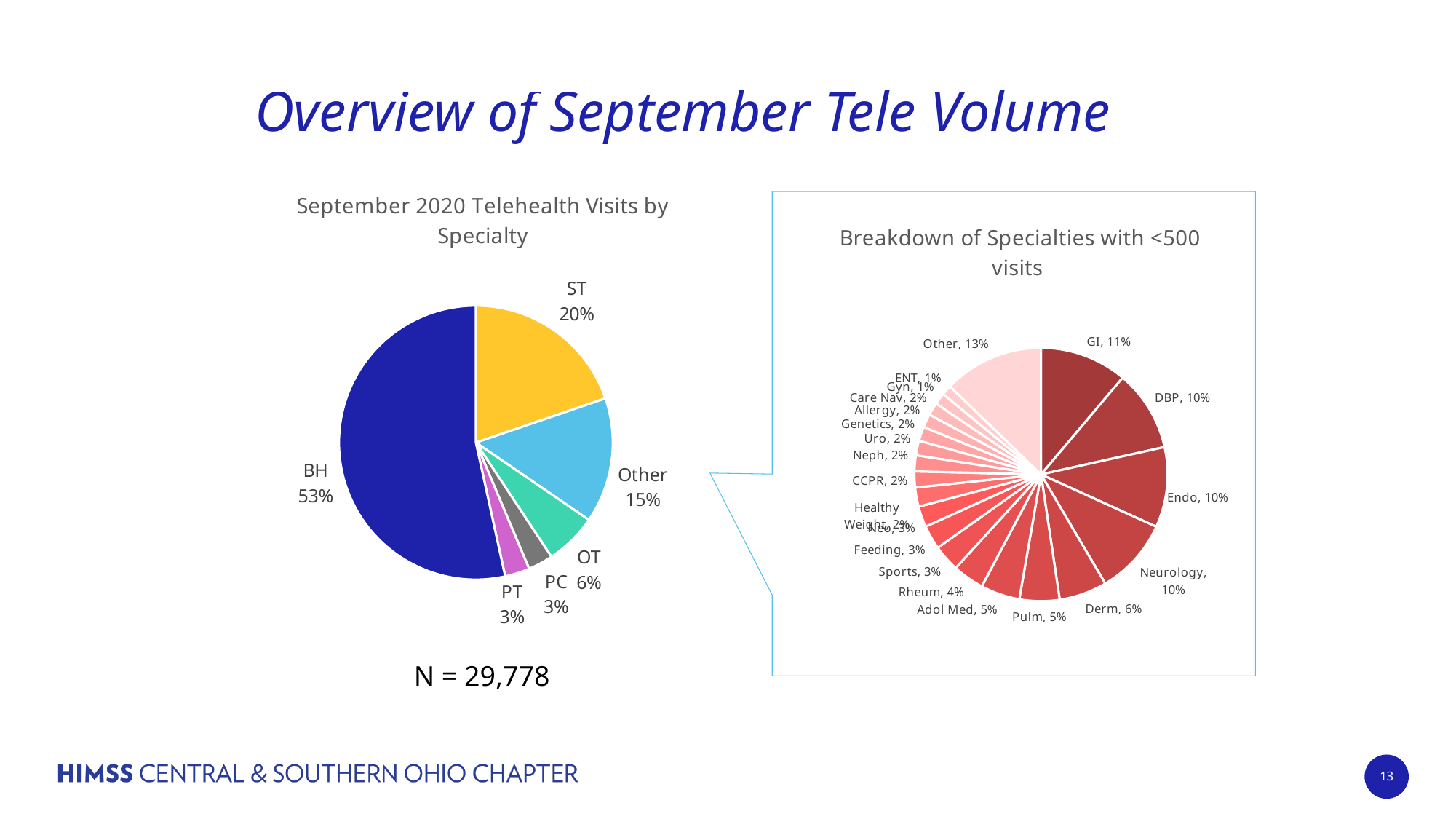
In the 'September 2020 Telehealth Visits by Specialty' pie chart, which specialty has the largest share? BH In the 'September 2020 Telehealth Visits by Specialty' pie chart, what is the difference in percentage points between ST and Other? 5 In the 'September 2020 Telehealth Visits by Specialty' pie chart, what share of visits is ST? 20% In the 'September 2020 Telehealth Visits by Specialty' pie chart, how many slices are there? 6 What kind of chart is 'Breakdown of Specialties with <500 visits'? Pie chart What is the N value shown under the left pie chart? N = 29,778 In the 'Breakdown of Specialties with <500 visits' pie chart, what share is Derm? 6% In the 'Breakdown of Specialties with <500 visits' pie chart, what share is GI? 11% In the 'Breakdown of Specialties with <500 visits' pie chart, which slice has the largest share? Other In the 'September 2020 Telehealth Visits by Specialty' pie chart, which is larger, OT or PC? OT In the 'Breakdown of Specialties with <500 visits' pie chart, which is larger, Pulm or Rheum? Pulm In the 'September 2020 Telehealth Visits by Specialty' pie chart, what share of visits is BH? 53%